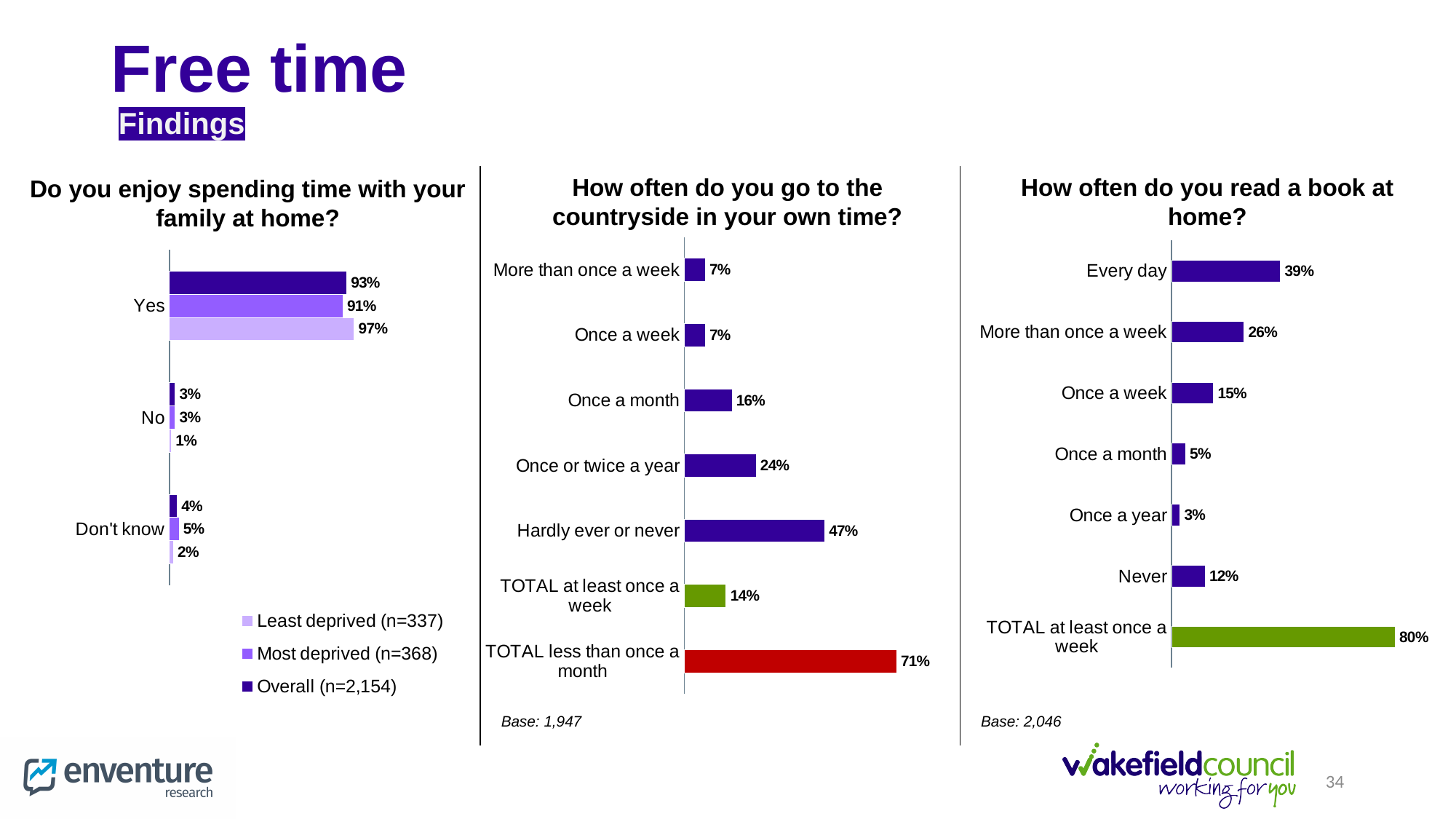
In the chart 'Do you enjoy spending time with your family at home?', how many series does the legend list? 3 In the chart 'How often do you go to the countryside in your own time?', what is the difference between Hardly ever or never and Once a month? 31% In the chart 'How often do you go to the countryside in your own time?', what kind of chart is it? Bar chart In the chart 'How often do you go to the countryside in your own time?', which category has the highest value? TOTAL less than once a month In the chart 'How often do you read a book at home?', what is the value for Every day? 39% In the chart 'How often do you read a book at home?', how many categories are shown? 7 In the chart 'How often do you read a book at home?', which is larger: Once a week or Never? Once a week In the chart 'How often do you read a book at home?', which category has the lowest value? Once a year In the chart 'Do you enjoy spending time with your family at home?', what is the difference between the Least deprived and Most deprived values for Yes? 6% In the chart 'Do you enjoy spending time with your family at home?', what is the Overall value for Yes? 93% In the chart 'Do you enjoy spending time with your family at home?', what is the Least deprived value for Don't know? 2% In the chart 'How often do you go to the countryside in your own time?', what is the value for Once or twice a year? 24%